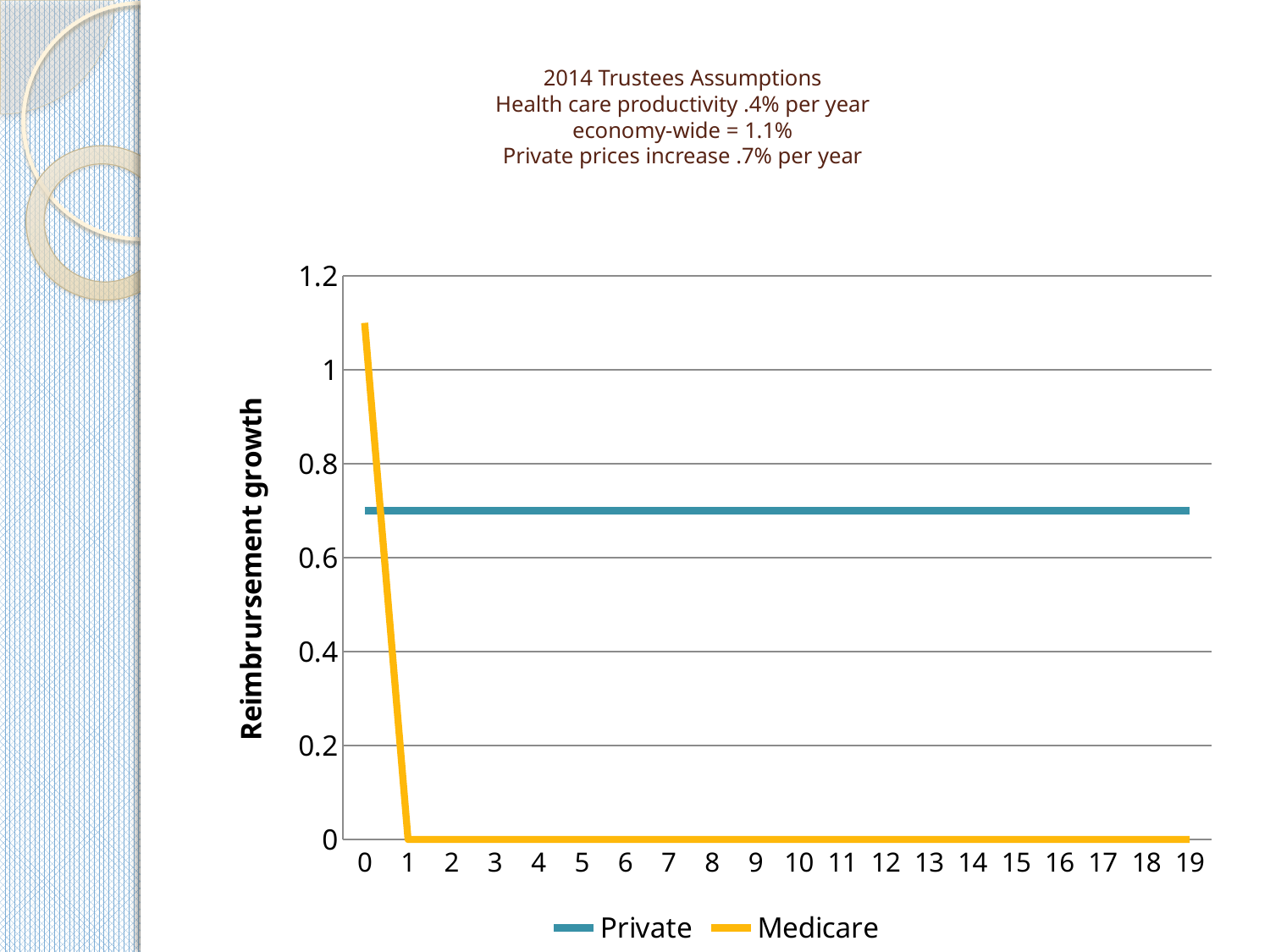
Does the Medicare line rise or fall between x = 0 and x = 1? fall What are the two series named in the legend? Private and Medicare How many series does the legend list? 2 Is the Medicare value at x = 0 greater or less than 1? greater What is the Medicare value at x = 19? 0 Is the Private value at x = 10 greater or less than 0.8? less What is the Medicare value at x = 5? 0 What is the label on the vertical axis? Reimbrursement growth At x = 10, which series has the larger value, Private or Medicare? Private Is the Private value at x = 10 greater or less than 0.6? greater At x = 0, which series has the larger value, Private or Medicare? Medicare What kind of chart is shown on the slide? line chart